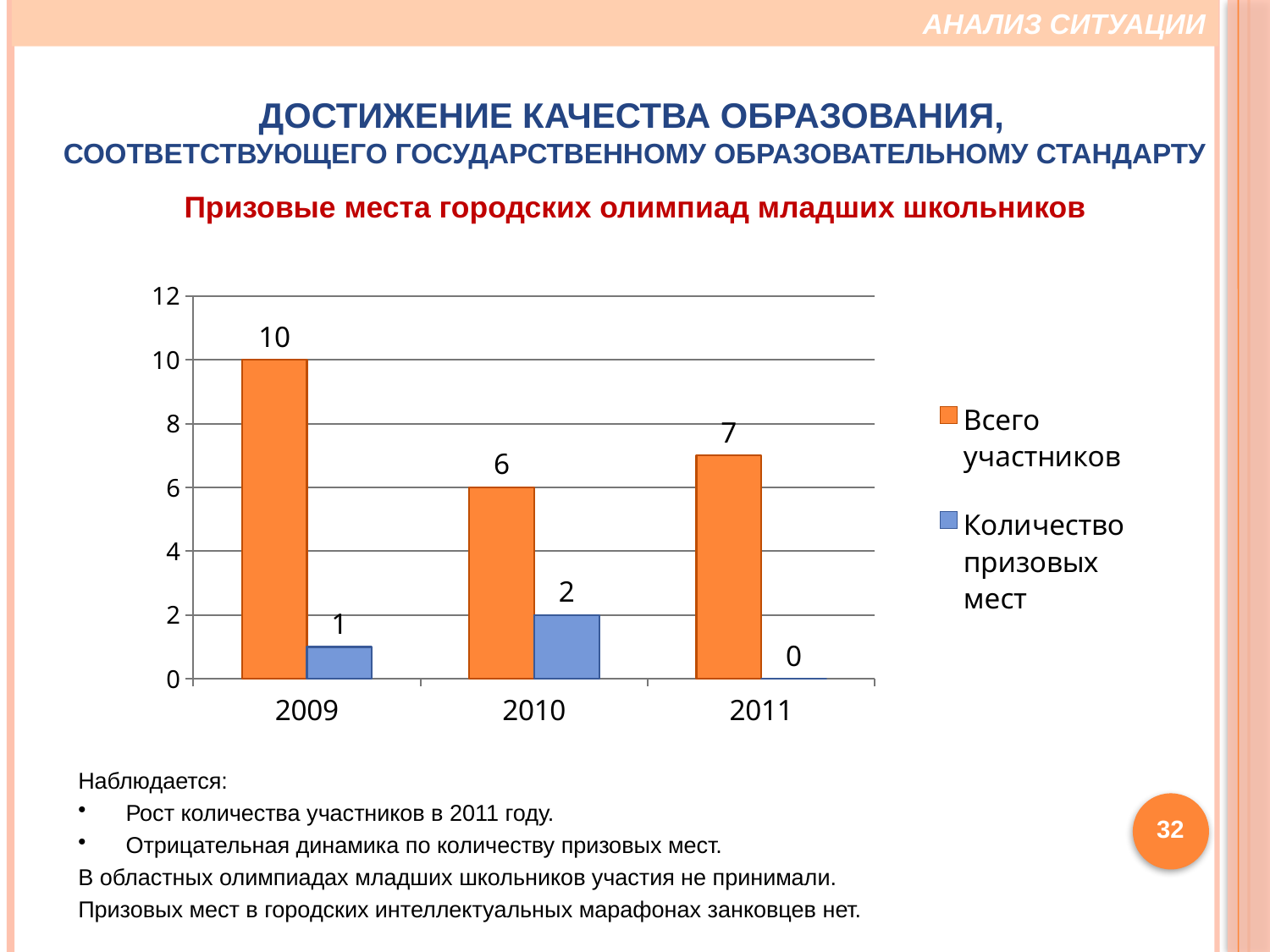
Which is larger: "Всего участников" in 2010 or in 2011? 2011 What is the title of the chart? Призовые места городских олимпиад младших школьников What is the value for "Количество призовых мест" in 2011? 0 How many series does the legend list? 2 How many years are shown on the x axis? 3 Which year has the lowest value for "Количество призовых мест"? 2011 What kind of chart is shown on the slide? bar chart Is the value for "Всего участников" in 2011 greater or less than 8? less Which year has the highest value for "Всего участников"? 2009 What is the value for "Всего участников" in 2009? 10 What is the difference between "Всего участников" in 2009 and in 2010? 4 What is the value for "Количество призовых мест" in 2010? 2